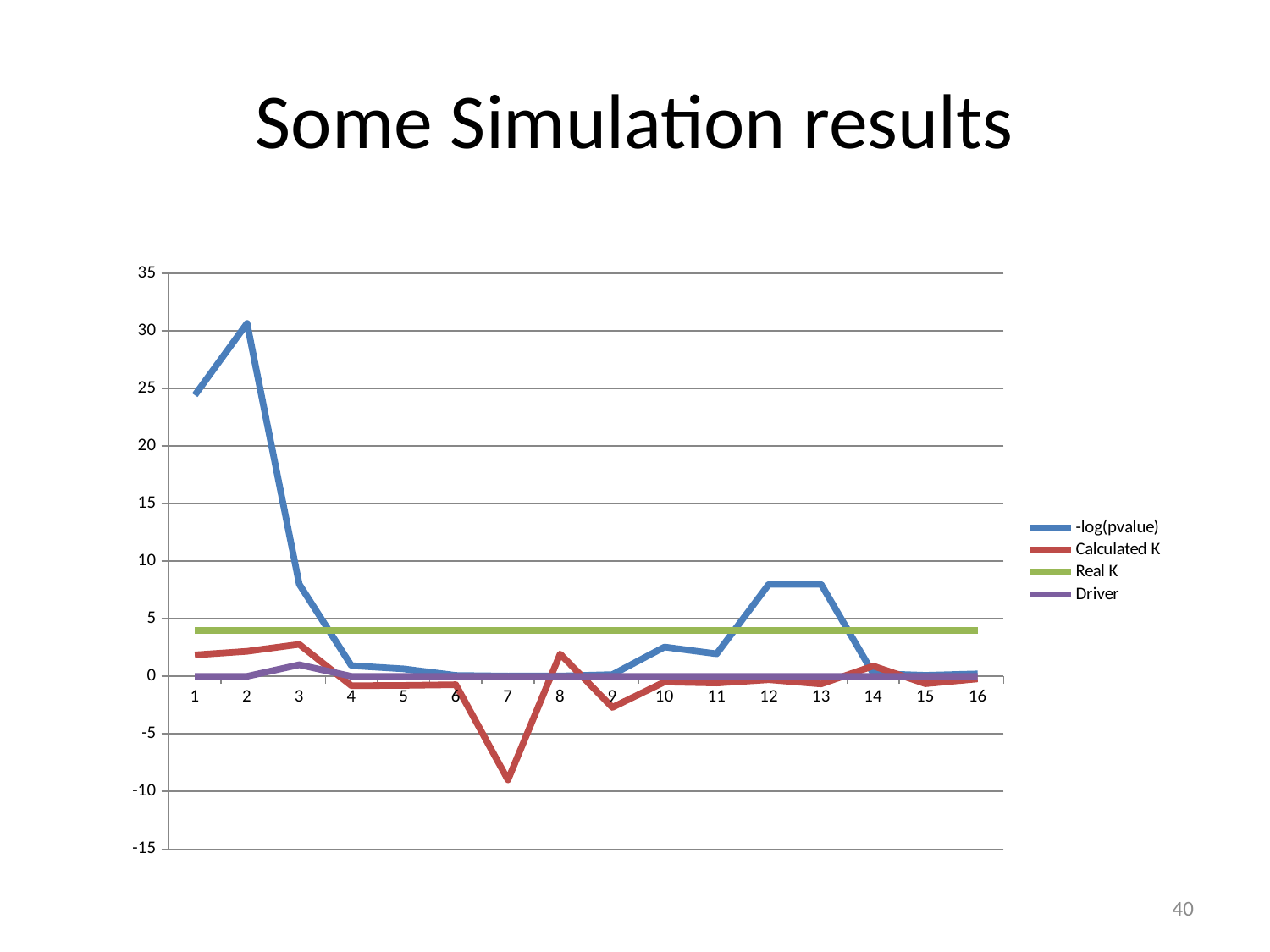
Does the -log(pvalue) series rise or fall between x = 2 and x = 4? fall Is the value of -log(pvalue) at x = 12 greater or less than 5? greater What kind of chart is shown on the slide? line chart Is the value of Real K greater or less than 5? less Is the value of -log(pvalue) at x = 2 greater or less than 25? greater Which is larger: the -log(pvalue) value at x = 2 or at x = 12? x = 2 At which x-axis value does the Calculated K series reach its lowest point? 7 At which x-axis value does the -log(pvalue) series reach its highest point? 2 What is the title of the slide containing the chart? Some Simulation results How many points are plotted along the x axis for each series? 16 How many series does the legend list? 4